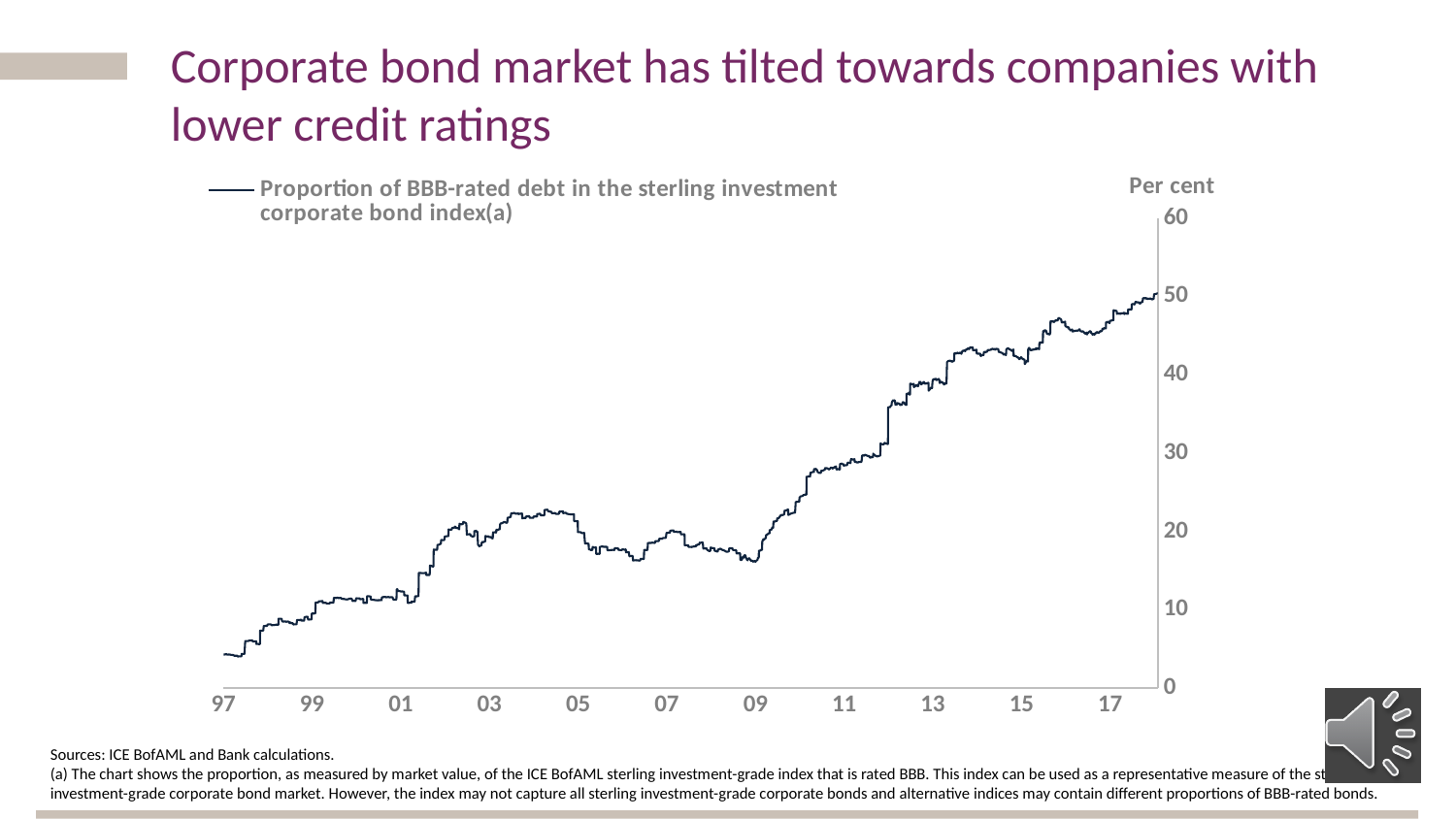
What is the unit shown on the vertical axis? Per cent Is the value for 13 greater or less than 30? greater What kind of chart is shown on the slide? line chart How many series does the legend list? 1 Is the value for 97 greater or less than 10? less What series does the legend name? Proportion of BBB-rated debt in the sterling investment corporate bond index(a) What is the highest value shown on the vertical axis? 60 Is the value for 09 greater or less than 20? less Which is larger, the value for 97 or the value for 17? 17 Overall, does the proportion of BBB-rated debt rise or fall from 97 to 17? rise